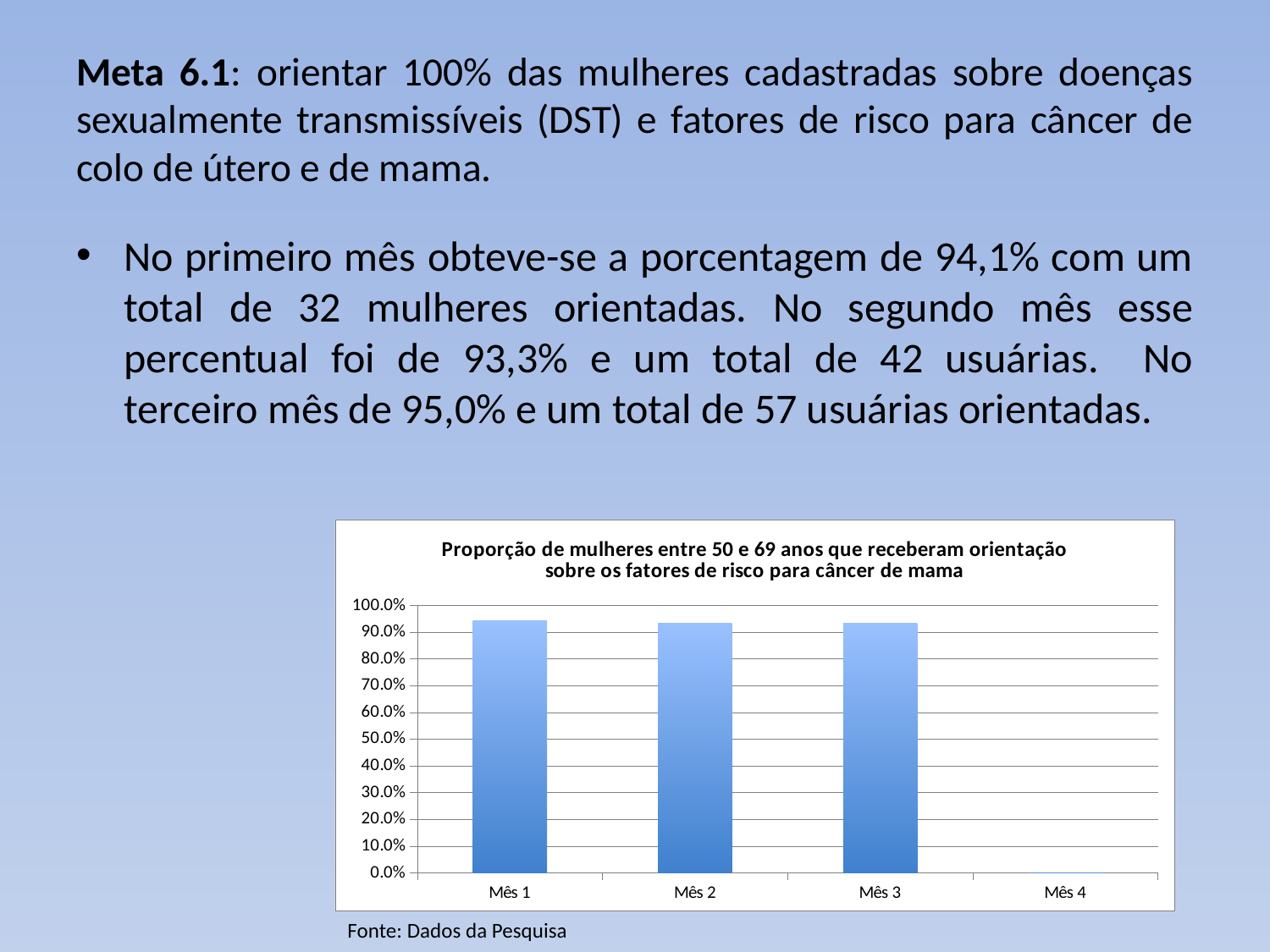
Is the value for Mês 3 greater or less than 100.0%? less How many categories are shown on the x axis of the chart? 4 Is the value for Mês 2 greater or less than 80.0%? greater What kind of chart is shown on the slide? bar chart Which category on the chart has no bar plotted? Mês 4 Which is larger, the value for Mês 1 or the value for Mês 4? Mês 1 Is the value for Mês 1 greater or less than 50.0%? greater What is the highest value shown on the y axis of the chart? 100.0% What is the title of the chart? Proporção de mulheres entre 50 e 69 anos que receberam orientação sobre os fatores de risco para câncer de mama